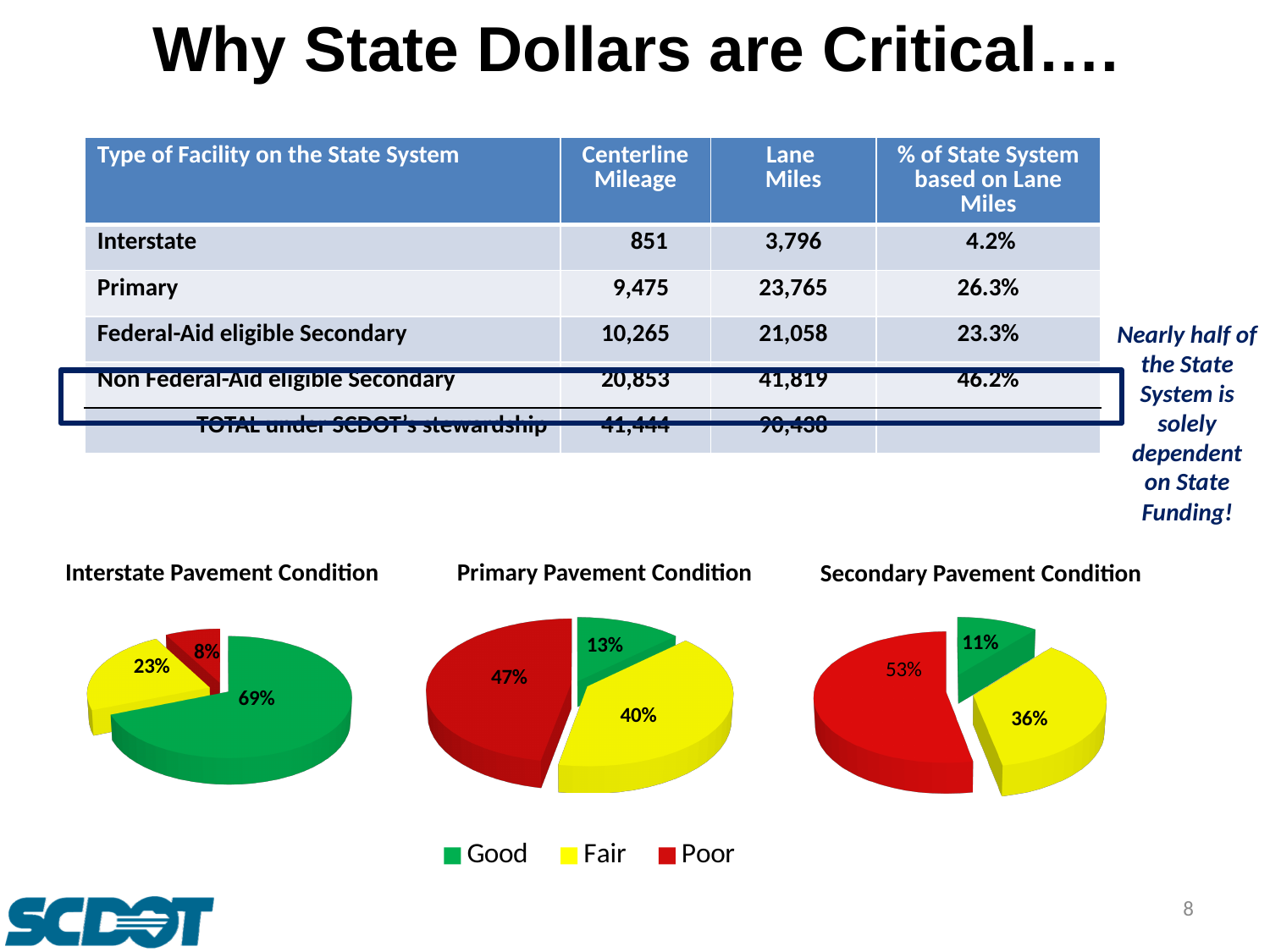
In the Secondary Pavement Condition chart, which condition category has the largest share? Poor In the Interstate Pavement Condition chart, which condition category has the smallest share? Poor In the Primary Pavement Condition chart, what percentage of pavement is in Poor condition? 47% In the Secondary Pavement Condition chart, what percentage of pavement is in Fair condition? 36% What type of chart is the Secondary Pavement Condition chart? Pie chart In the Primary Pavement Condition chart, what is the difference between the Poor share and the Good share? 34% Which is larger: the Good share in the Interstate Pavement Condition chart or the Good share in the Secondary Pavement Condition chart? Interstate Pavement Condition How many slices does the Interstate Pavement Condition chart have? 3 In the Interstate Pavement Condition chart, what percentage of pavement is in Good condition? 69% In the pavement condition charts, what colour represents the Fair category? Yellow How many categories does the shared legend below the pavement condition charts list? 3 In the Primary Pavement Condition chart, which condition category has the smallest share? Good